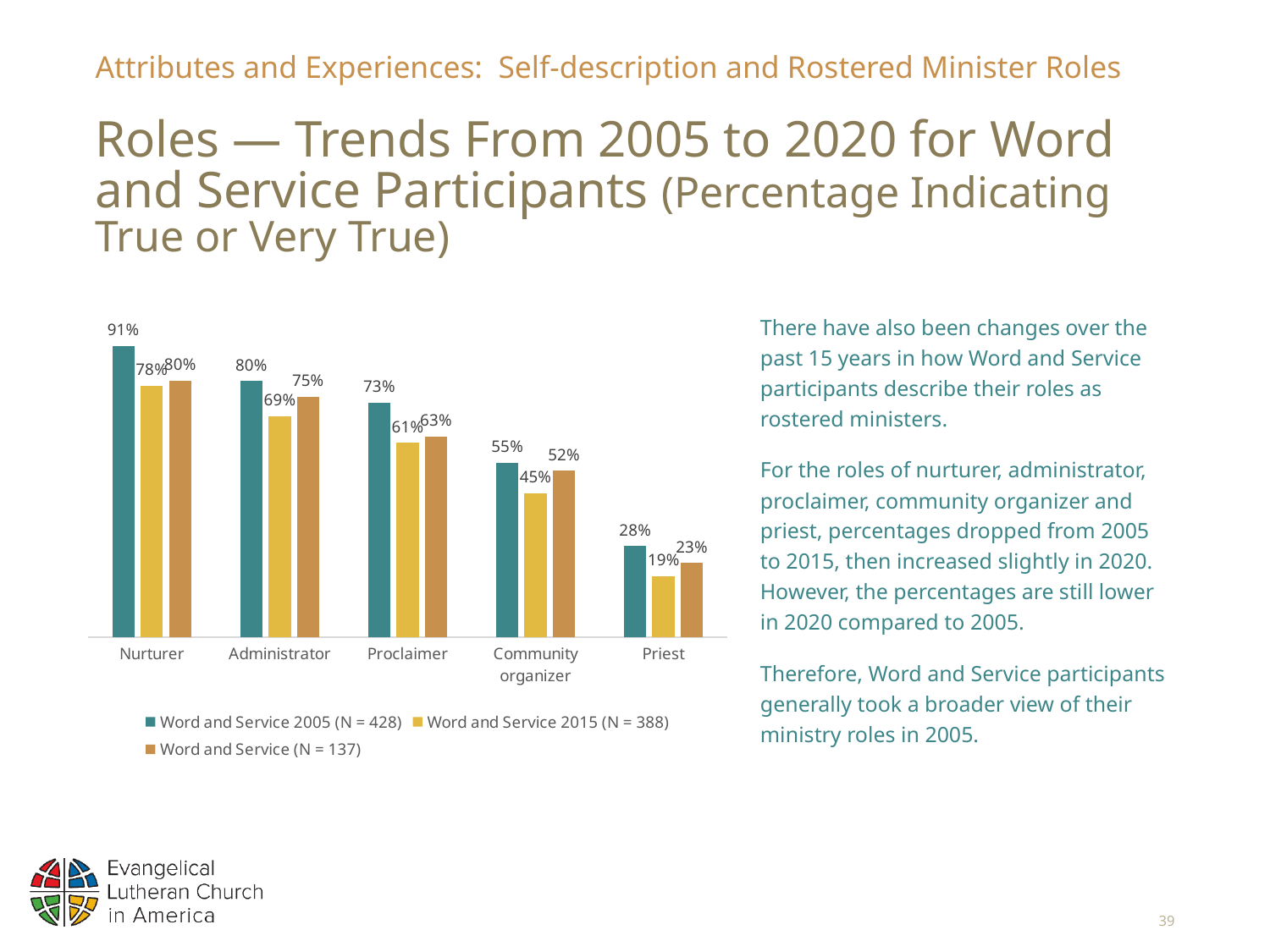
What is the value for Priest in the Word and Service (N = 137) series? 23% What is the sample size (N) given in the legend for the Word and Service 2015 series? 388 What is the difference between the Word and Service 2005 (N = 428) and Word and Service 2015 (N = 388) values for Administrator? 11% What is the value for Nurturer in the Word and Service 2005 (N = 428) series? 91% What is the value for Community organizer in the Word and Service 2015 (N = 388) series? 45% Do the values in the Word and Service 2005 (N = 428) series rise or fall from Nurturer to Priest along the x axis? Fall What kind of chart is shown on the slide? Bar chart Which is larger for Proclaimer: the Word and Service 2015 (N = 388) value or the Word and Service (N = 137) value? Word and Service (N = 137) How many series does the chart's legend list? 3 How many categories are shown on the x axis of the chart? 5 Which category has the lowest value in the Word and Service 2005 (N = 428) series? Priest Which category has the highest value in the Word and Service 2015 (N = 388) series? Nurturer